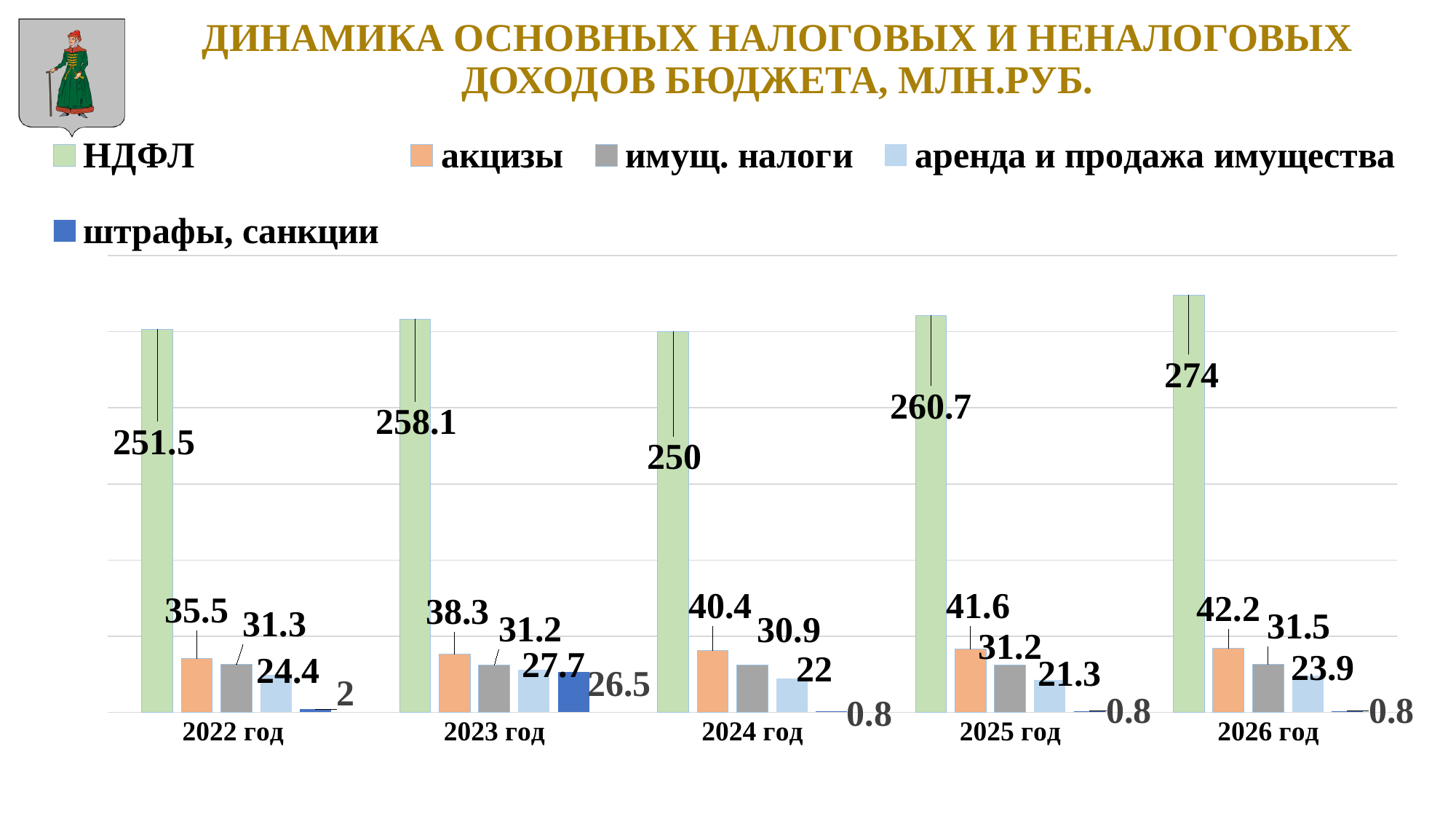
What kind of chart is shown on the slide? bar chart Which is larger in 2024 год: акцизы or имущ. налоги? акцизы What is the value of НДФЛ for 2026 год? 274 How many series does the legend list? 5 What is the value of аренда и продажа имущества for 2025 год? 21.3 What is the difference between НДФЛ in 2026 год and 2022 год? 22.5 What is the value of акцизы for 2023 год? 38.3 In which year is НДФЛ the lowest? 2024 год What is the value of штрафы, санкции for 2023 год? 26.5 How many years are shown on the x axis? 5 In which year is НДФЛ the highest? 2026 год Do the values for акцизы rise or fall from 2022 год to 2026 год? rise